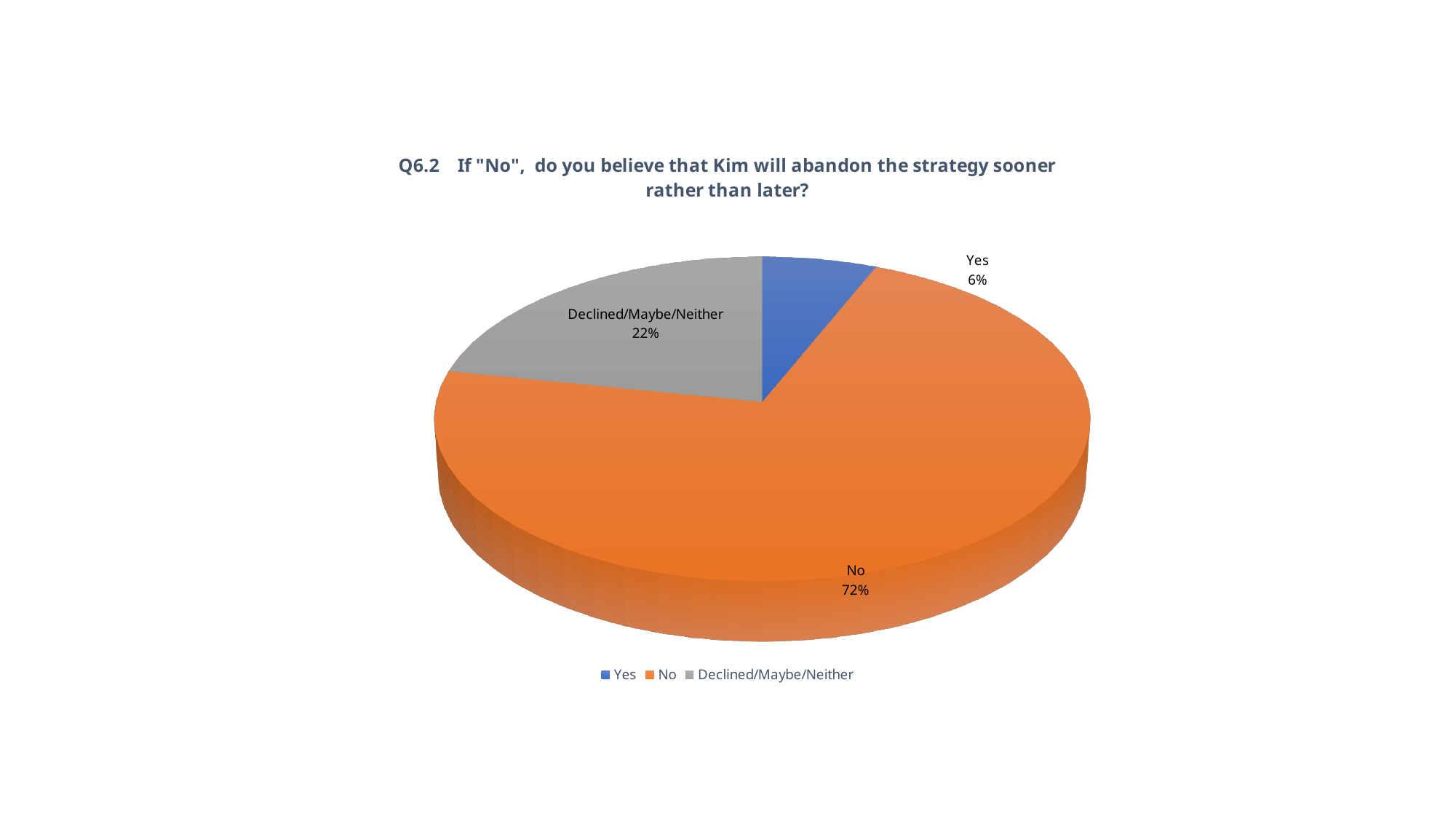
What share of the pie is labelled Declined/Maybe/Neither? 22% Which response has the smallest slice of the pie? Yes Which is larger, the "Yes" slice or the Declined/Maybe/Neither slice? Declined/Maybe/Neither What percentage of respondents answered "Yes"? 6% Which response has the largest slice of the pie? No What kind of chart is shown on the slide? pie chart How many slices does the pie chart have? 3 How many entries does the legend list? 3 What is the difference in percentage points between the "No" and "Yes" slices? 66 What colour is the "No" slice of the pie? orange What is the difference in percentage points between the Declined/Maybe/Neither and "Yes" slices? 16 What percentage of respondents answered "No"? 72%